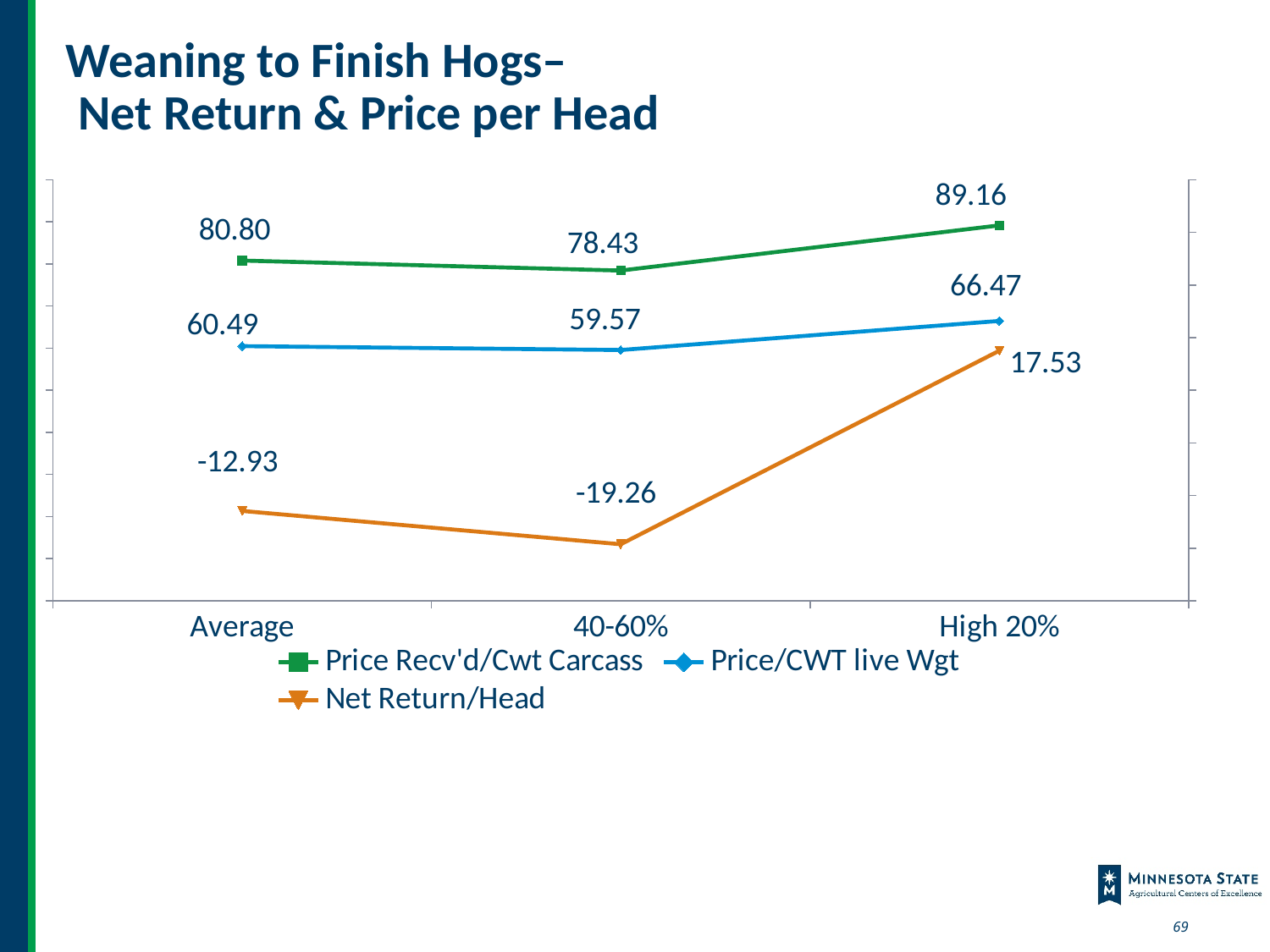
What kind of chart is shown on the slide? Line chart Which category has the lowest Price Recv'd/Cwt Carcass? 40-60% Which series is drawn in orange? Net Return/Head What is the Price/CWT live Wgt value for the Average category? 60.49 Which is larger: the Price/CWT live Wgt for 40-60% or for High 20%? High 20% How many series does the legend list? 3 How many categories are shown on the x axis? 3 What is the Net Return/Head value for the 40-60% category? -19.26 Does the Net Return/Head series rise or fall from 40-60% to High 20%? Rise Which category has the highest Net Return/Head? High 20% What is the Price Recv'd/Cwt Carcass value for the High 20% category? 89.16 What is the difference between the Price Recv'd/Cwt Carcass values for High 20% and Average? 8.36